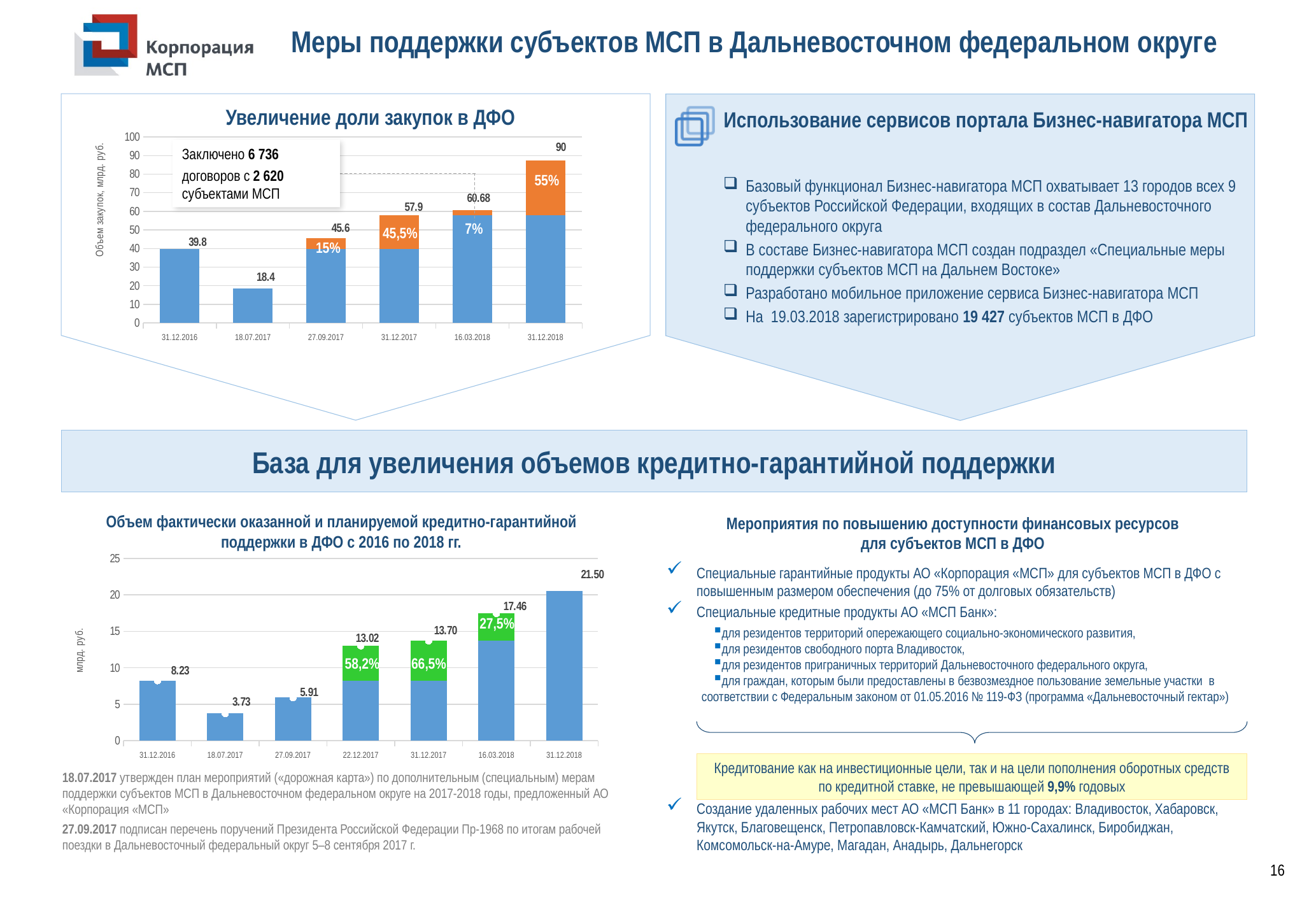
In the bottom-left chart 'Объем фактически оказанной и планируемой кредитно-гарантийной поддержки в ДФО', what is the value for 22.12.2017? 13.02 In the chart 'Увеличение доли закупок в ДФО', what is the value for 31.12.2016? 39.8 In the bottom-left chart 'Объем фактически оказанной и планируемой кредитно-гарантийной поддержки в ДФО', which is larger: the value for 31.12.2016 or the value for 27.09.2017? 31.12.2016 In the chart 'Увеличение доли закупок в ДФО', what percentage label is shown on the orange segment for 31.12.2018? 55% In the chart 'Увеличение доли закупок в ДФО', how many dates are shown on the x axis? 6 In the chart 'Увеличение доли закупок в ДФО', what is the value for 16.03.2018? 60.68 In the bottom-left chart 'Объем фактически оказанной и планируемой кредитно-гарантийной поддержки в ДФО', which date has the lowest value? 18.07.2017 In the chart 'Увеличение доли закупок в ДФО', which date has the lowest value? 18.07.2017 In the chart 'Увеличение доли закупок в ДФО', which date has the highest value? 31.12.2018 In the chart 'Увеличение доли закупок в ДФО', what is the difference between the values for 31.12.2018 and 31.12.2016? 50.2 What kind of chart is the bottom-left chart 'Объем фактически оказанной и планируемой кредитно-гарантийной поддержки в ДФО'? bar chart In the bottom-left chart 'Объем фактически оказанной и планируемой кредитно-гарантийной поддержки в ДФО', how many dates are shown on the x axis? 7